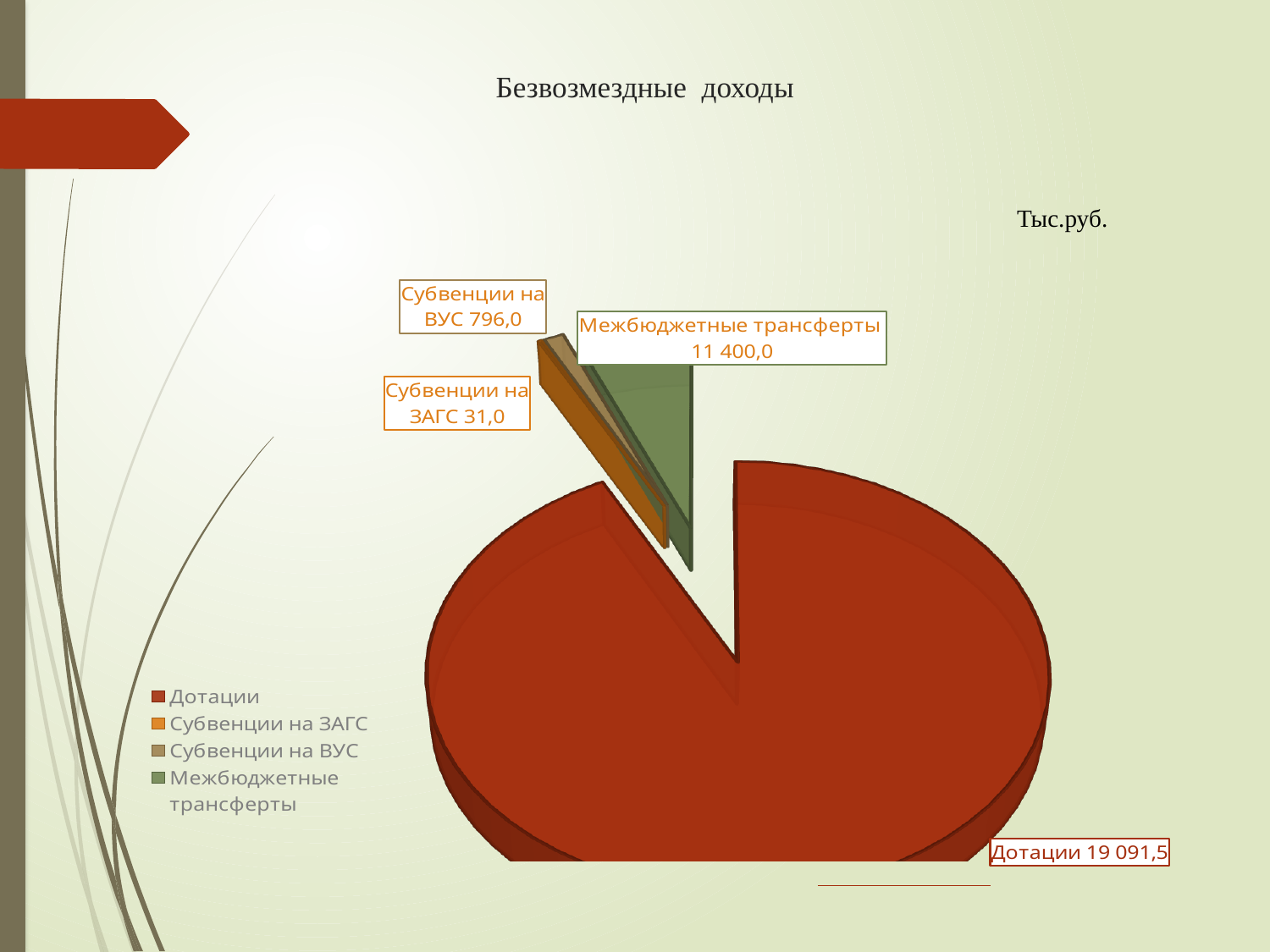
Which category has the largest value? Дотации What unit is indicated for the values on the slide? Тыс.руб. Which is larger, Межбюджетные трансферты or Субвенции на ВУС? Межбюджетные трансферты What is the title of the chart? Безвозмездные доходы Which category has the smallest value? Субвенции на ЗАГС What type of chart is shown on the slide? Pie chart What is the difference between Дотации and Межбюджетные трансферты? 7 691,5 How many categories does the legend list? 4 What is the value for Субвенции на ВУС? 796,0 What is the value for Межбюджетные трансферты? 11 400,0 What is the value for Дотации? 19 091,5 What is the value for Субвенции на ЗАГС? 31,0